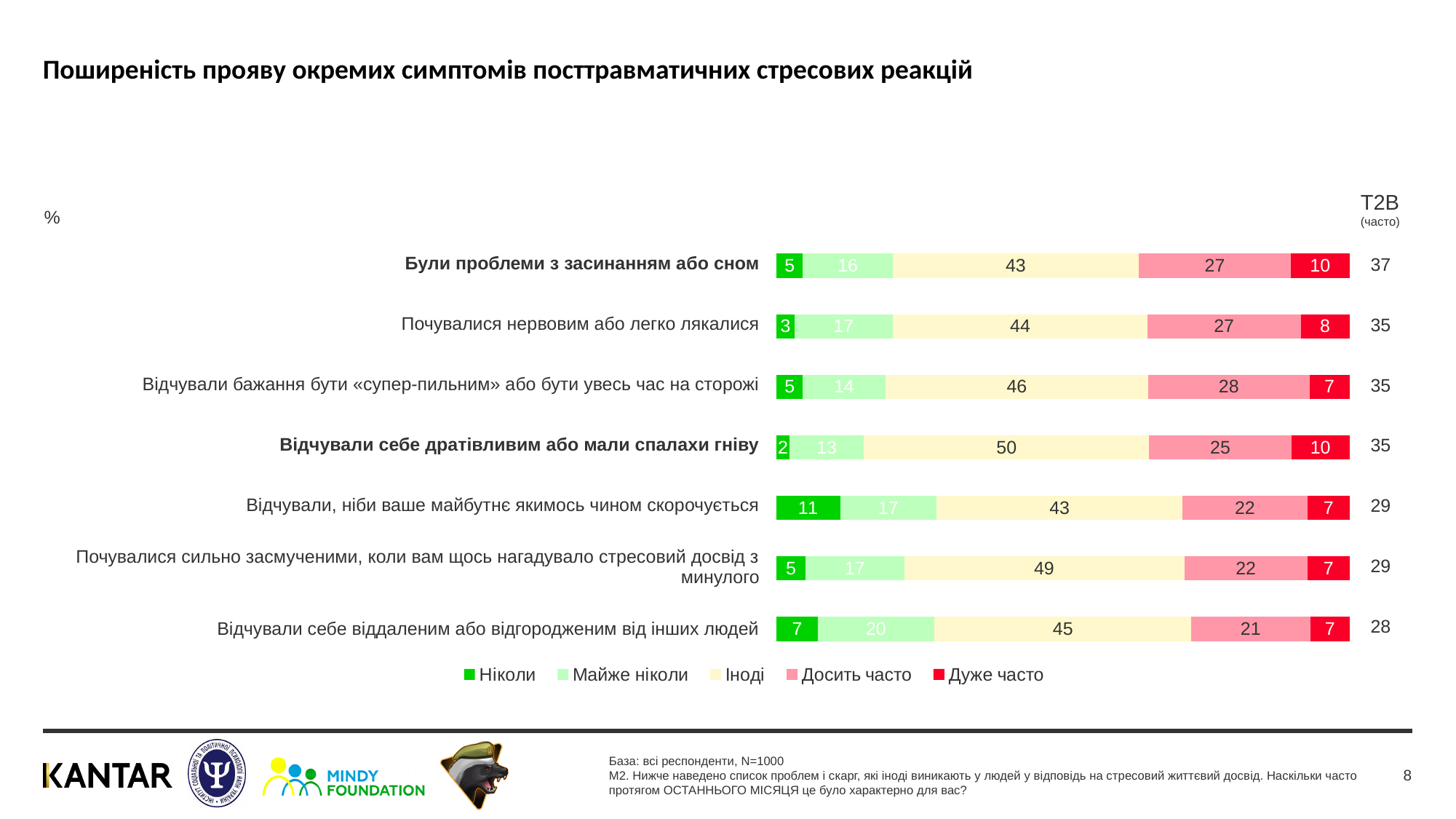
What type of chart is shown on the slide? Stacked bar chart Which category has the highest T2B (часто) value? Були проблеми з засинанням або сном Which is larger: the "Ніколи" value for "Відчували, ніби ваше майбутнє якимось чином скорочується" or for "Відчували себе віддаленим або відгородженим від інших людей"? Відчували, ніби ваше майбутнє якимось чином скорочується What is the total of the stacked bar for "Відчували себе віддаленим або відгородженим від інших людей"? 100 What is the value of "Дуже часто" for "Були проблеми з засинанням або сном"? 10 Which category has the highest "Іноді" value? Відчували себе дратівливим або мали спалахи гніву What is the value of "Іноді" for "Відчували себе дратівливим або мали спалахи гніву"? 50 Which category has the lowest "Ніколи" value? Відчували себе дратівливим або мали спалахи гніву What is the difference between the "Досить часто" values for "Відчували бажання бути «супер-пильним» або бути увесь час на сторожі" and "Відчували себе віддаленим або відгородженим від інших людей"? 7 How many series does the legend list? 5 How many symptom categories are plotted in the chart? 7 What is the T2B (часто) value for "Відчували себе віддаленим або відгородженим від інших людей"? 28